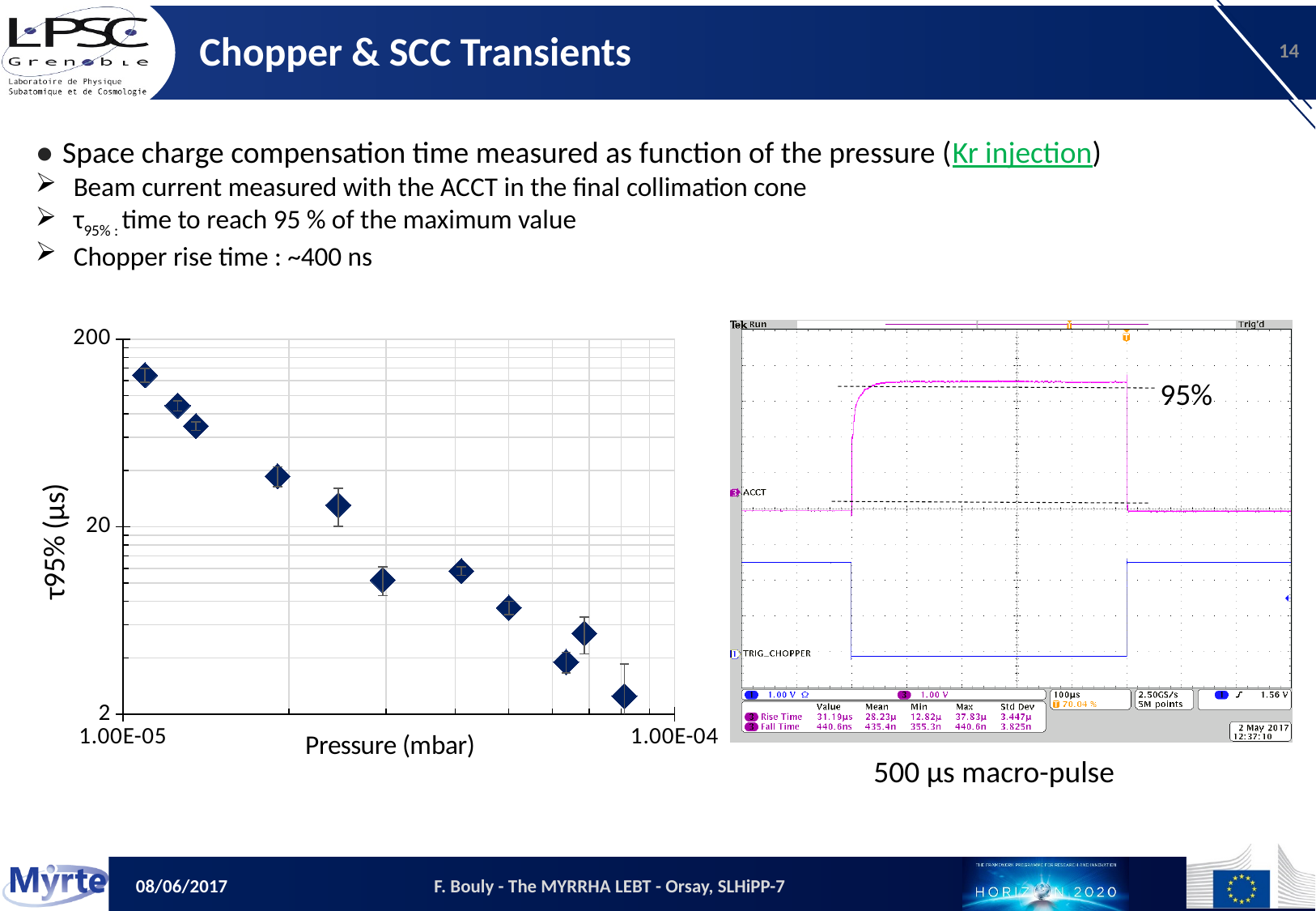
What kind of chart is shown on the left of the slide, plotting τ95% against pressure? scatter chart In the τ95% versus pressure chart, which has the larger τ95% value: the leftmost point or the rightmost point? the leftmost point In the τ95% versus pressure chart, does τ95% rise or fall as the pressure increases along the x axis? fall What is the label of the x axis of the τ95% chart? Pressure (mbar) In the τ95% versus pressure chart, is the τ95% value of the leftmost point greater or less than 200? less In the τ95% versus pressure chart, is the τ95% value of the rightmost (highest-pressure) point greater or less than 20? less In the τ95% versus pressure chart, which point has the highest τ95% value: the one at the lowest pressure or the one at the highest pressure? the one at the lowest pressure What are the minimum and maximum tick values shown on the y axis of the τ95% chart? 2 and 200 In the τ95% versus pressure chart, which point has the lowest τ95% value: the leftmost point or the rightmost point? the rightmost point In the τ95% versus pressure chart, is the τ95% value of the leftmost (lowest-pressure) point greater or less than 20? greater In the τ95% versus pressure chart, how many data points are plotted? 11